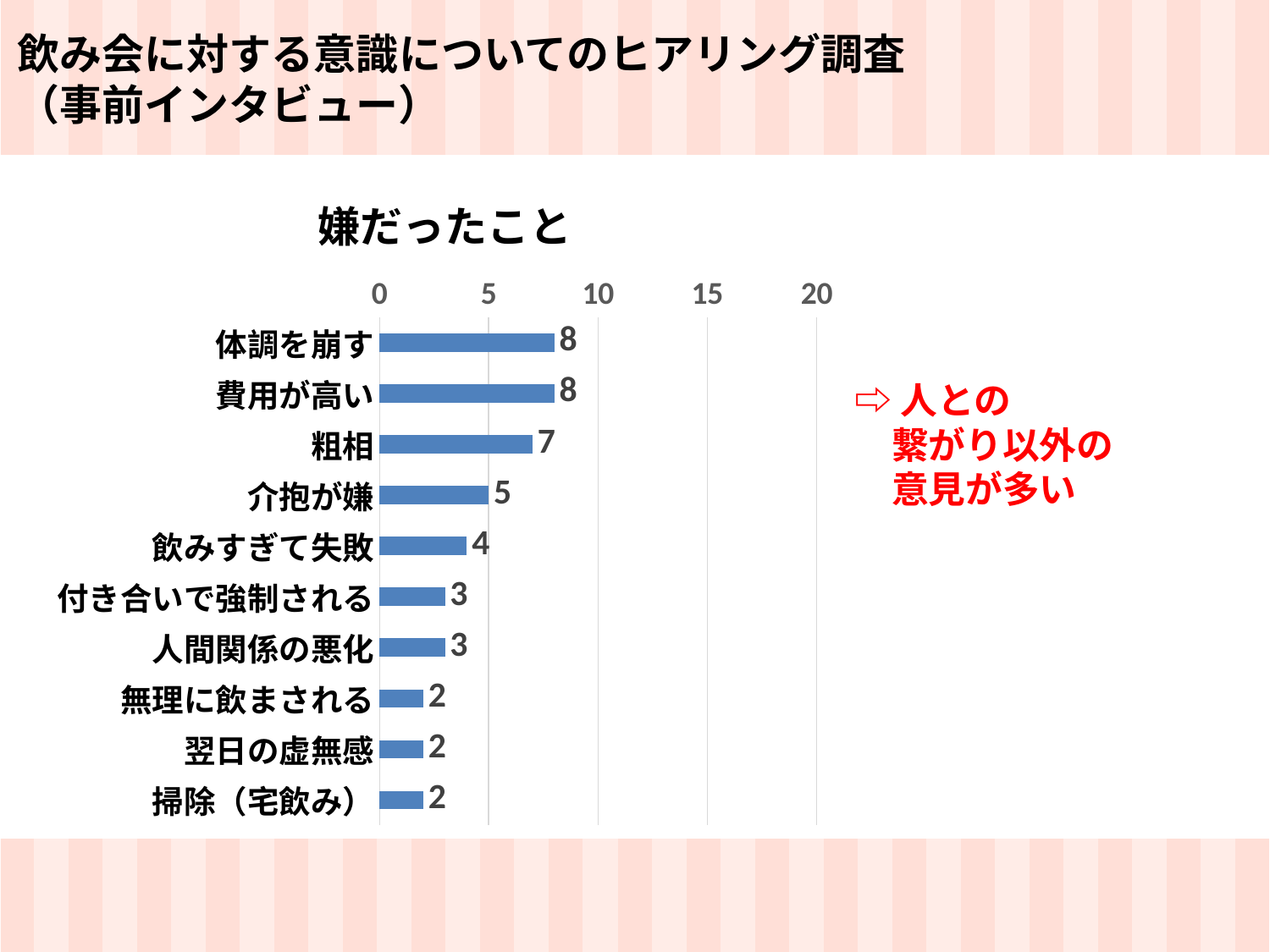
What is the title of the chart? 嫌だったこと What kind of chart is shown on the slide? bar chart How many categories are shown in the chart? 10 What is the value for 粗相? 7 What is the difference between the values for 粗相 and 掃除（宅飲み）? 5 What is the value for 体調を崩す? 8 What is the value for 介抱が嫌? 5 What is the difference between the values for 費用が高い and 人間関係の悪化? 5 Which category has the lowest value among 介抱が嫌, 粗相 and 飲みすぎて失敗? 飲みすぎて失敗 Is the value for 体調を崩す greater or less than 5? greater Which is larger, the value for 粗相 or the value for 介抱が嫌? 粗相 What is the value for 飲みすぎて失敗? 4